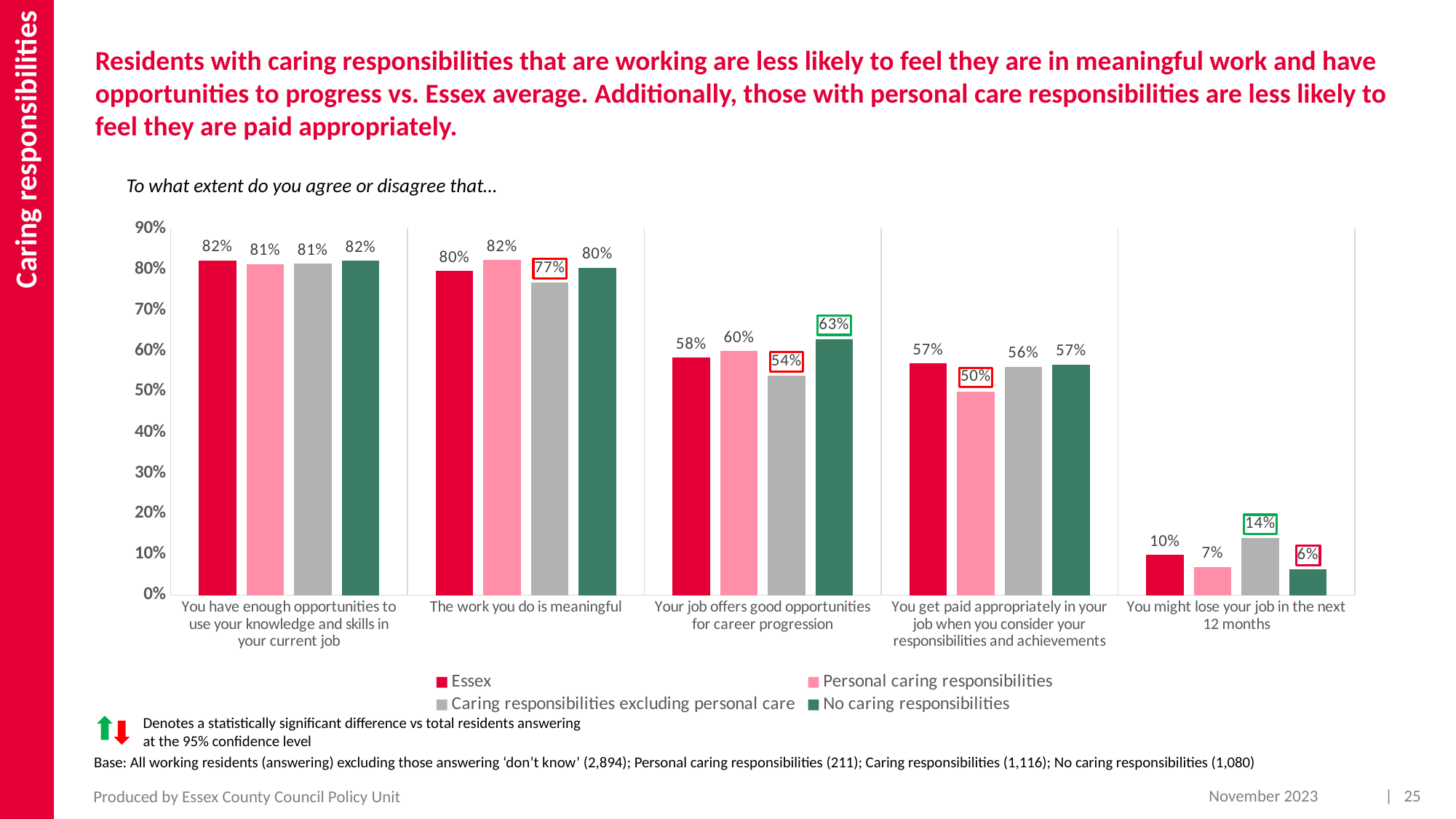
Which series has the highest value for 'Your job offers good opportunities for career progression'? No caring responsibilities Which series has the lowest value for 'You might lose your job in the next 12 months'? No caring responsibilities What kind of chart is shown on the slide? Bar chart What percentage of Essex residents agree that the work they do is meaningful? 80% What is the difference between the 'Personal caring responsibilities' value and the 'Essex' value for 'You get paid appropriately in your job when you consider your responsibilities and achievements'? 7 percentage points What is the value for 'Caring responsibilities excluding personal care' for 'You might lose your job in the next 12 months'? 14% What is the maximum value shown on the y axis? 90% How many series does the legend list? 4 What is the value for 'Personal caring responsibilities' for 'You get paid appropriately in your job when you consider your responsibilities and achievements'? 50% For 'The work you do is meaningful', which is larger: the value for 'Personal caring responsibilities' or for 'Caring responsibilities excluding personal care'? Personal caring responsibilities What is the value for 'No caring responsibilities' for 'Your job offers good opportunities for career progression'? 63% How many statement categories are shown on the x axis? 5